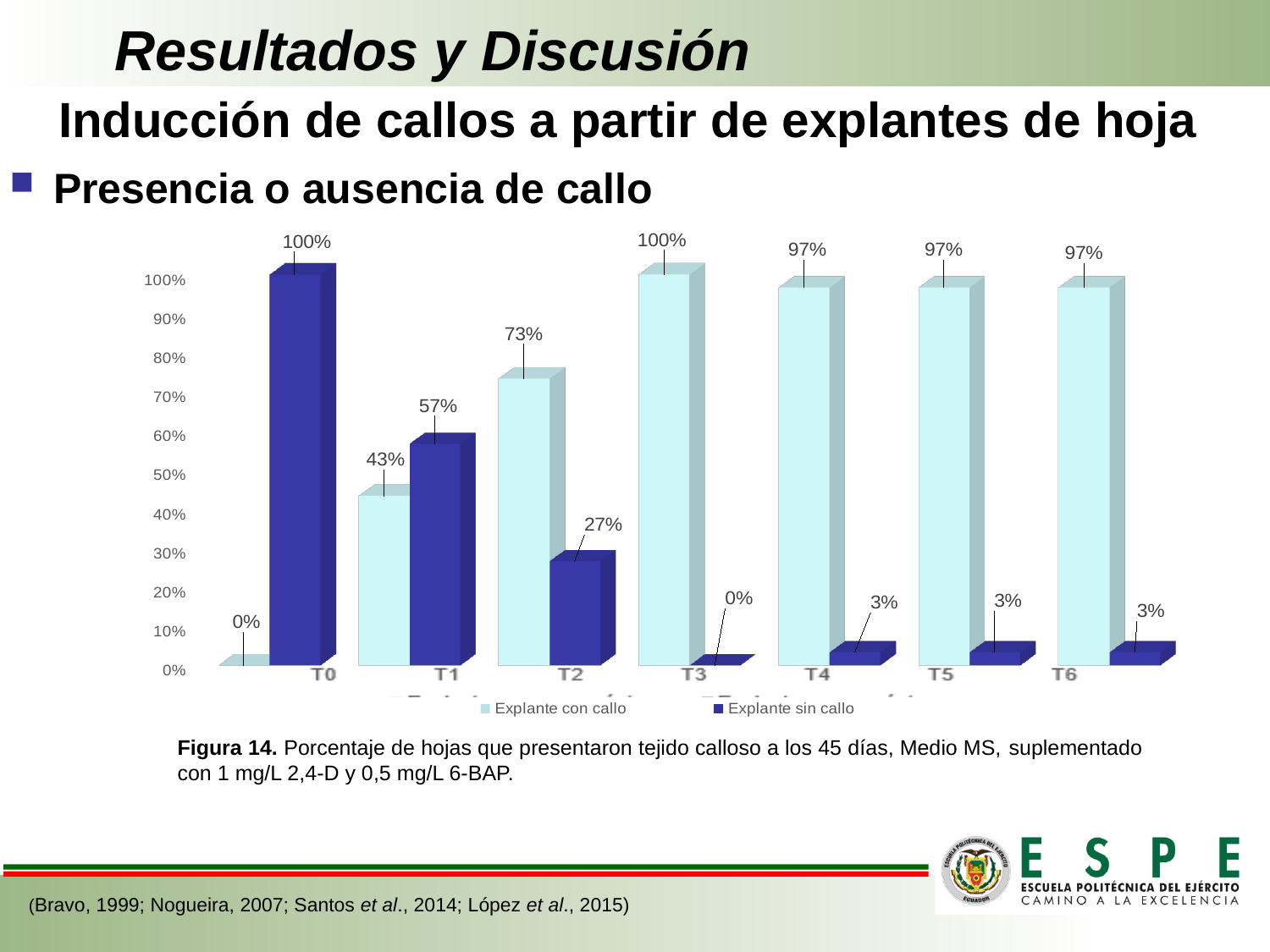
How many series does the legend list? 2 What is the total of "Explante con callo" and "Explante sin callo" at T5? 100% What is the difference between "Explante con callo" and "Explante sin callo" at T2? 46% What is the value for "Explante sin callo" at T0? 100% How many treatments are shown on the x axis? 7 What is the value for "Explante con callo" at T1? 43% Which treatment has the highest value for "Explante sin callo"? T0 What is the value for "Explante sin callo" at T2? 27% What is the value for "Explante con callo" at T4? 97% At T1, which is larger: "Explante con callo" or "Explante sin callo"? Explante sin callo What kind of chart is shown on the slide? Bar chart Which treatment has the lowest value for "Explante con callo"? T0